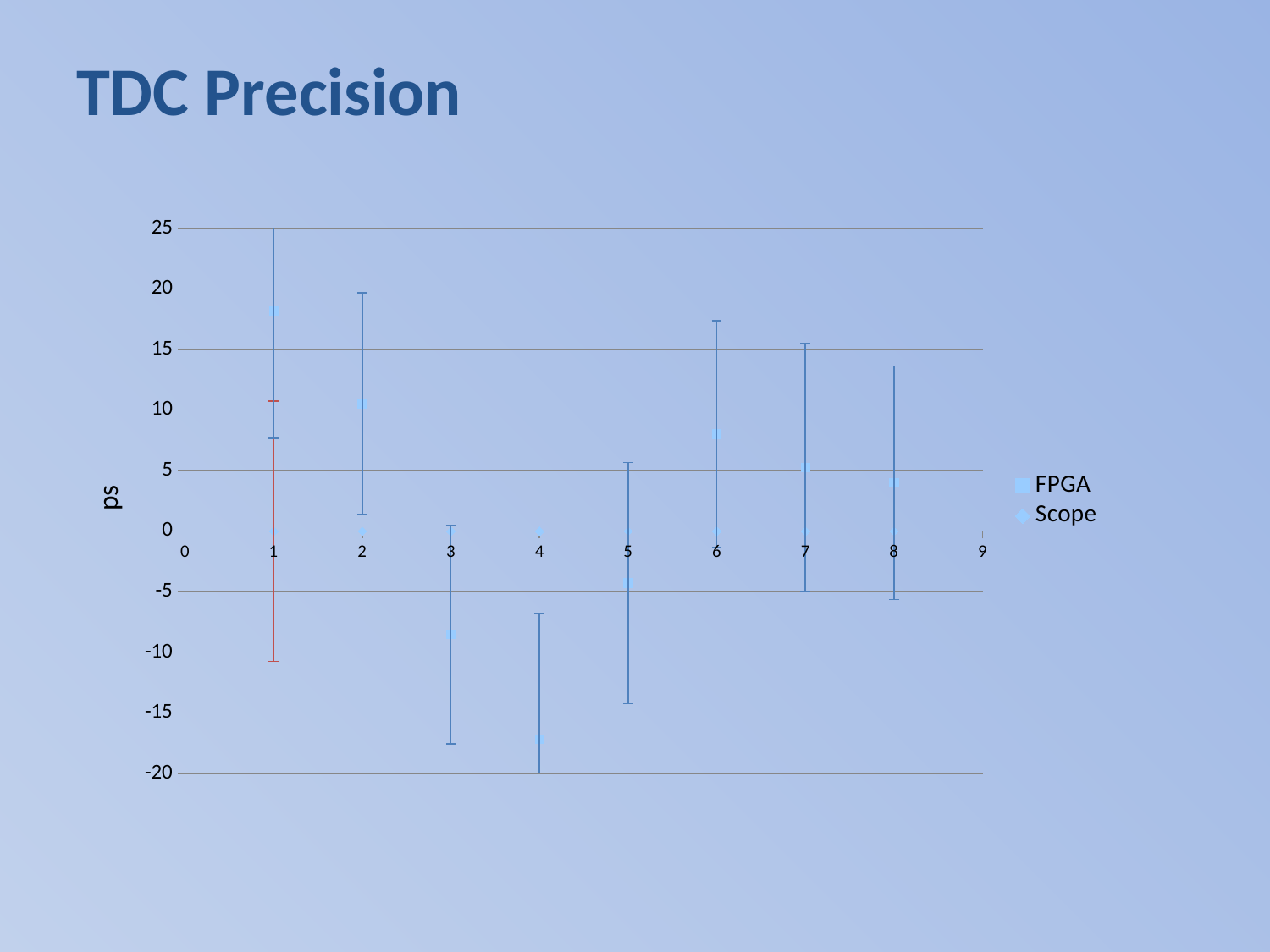
Is the FPGA value at x = 4 greater or less than -15? less How many series does the legend list? 2 What are the two series named in the legend? FPGA and Scope Which has the larger FPGA value, x = 1 or x = 2? x = 1 Is the FPGA value at x = 3 greater or less than -5? less What is the label on the vertical axis? ps Is the FPGA value at x = 6 greater or less than 5? greater What kind of chart is shown on the slide? scatter chart At which x value is the FPGA value lowest? 4 How many FPGA data points are plotted? 8 At which x value is the FPGA value highest? 1